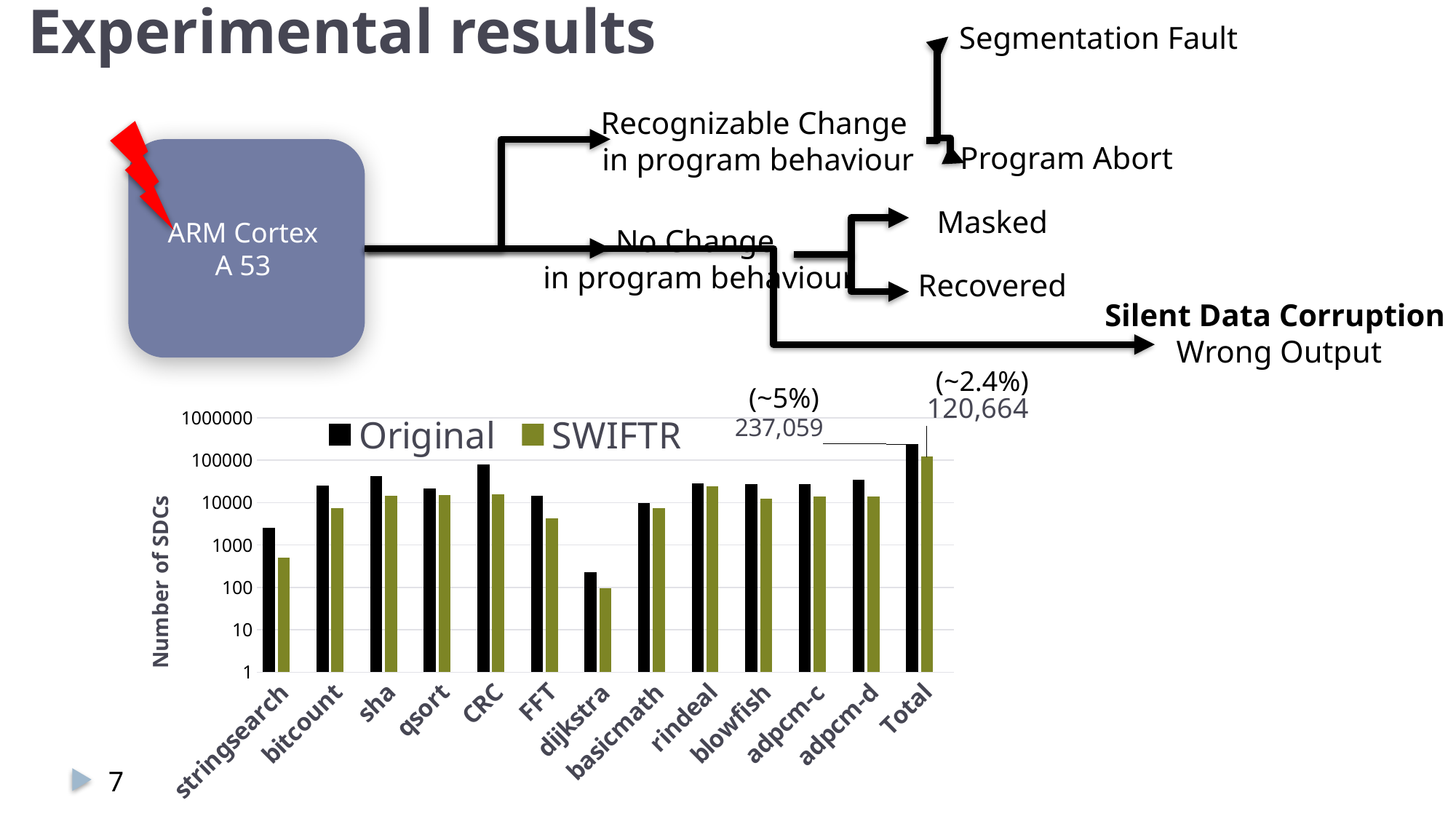
What is the label of the y axis of the chart? Number of SDCs What type of chart is shown on the slide? bar chart Is the Original value for stringsearch greater or less than 1000? greater What is the difference between the Original and SWIFTR values for Total? 116,395 Which category has the lowest SWIFTR value? dijkstra What is the Original value for Total? 237,059 How many series does the chart legend list? 2 How many categories are shown on the x axis of the chart? 13 Which category has the lowest Original value? dijkstra What is the SWIFTR value for Total? 120,664 Is the SWIFTR value for stringsearch greater or less than 1000? less